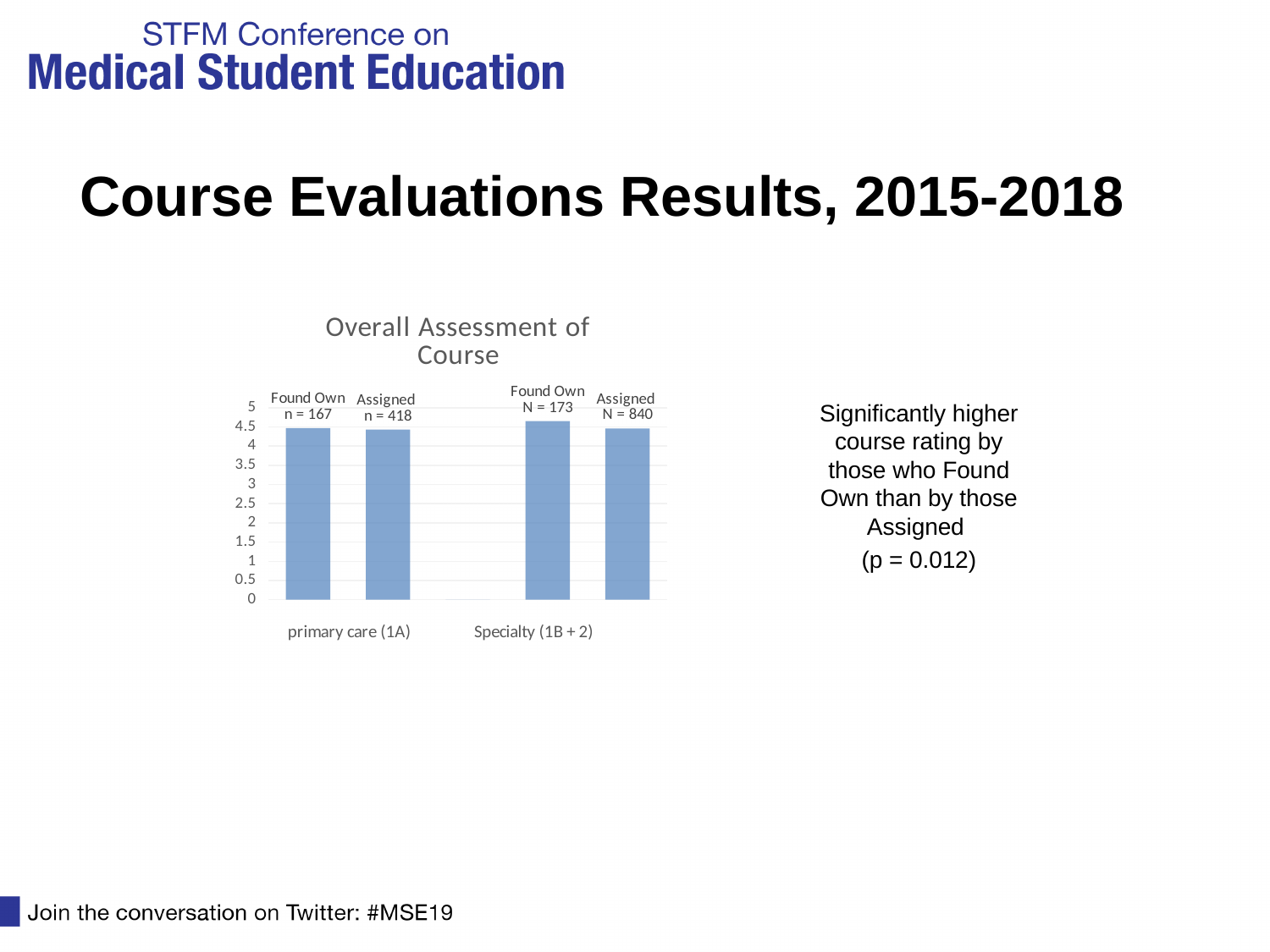
Is the value for Found Own in the Specialty (1B + 2) group greater or less than 4.5? greater What kind of chart is shown on the slide? bar chart Is the value for Assigned in the primary care (1A) group greater or less than 4? greater In the Specialty (1B + 2) group, which is larger, Found Own or Assigned? Found Own What is the title of the chart? Overall Assessment of Course Is the value for Found Own in the primary care (1A) group greater or less than 5? less Which bar is the highest in the chart? Found Own in Specialty (1B + 2) What is the sample size shown for Assigned in the Specialty (1B + 2) group? N = 840 What is the maximum value shown on the y axis of the chart? 5 How many bars are plotted in the chart? 4 How many category groups are labelled on the x axis of the chart? 2